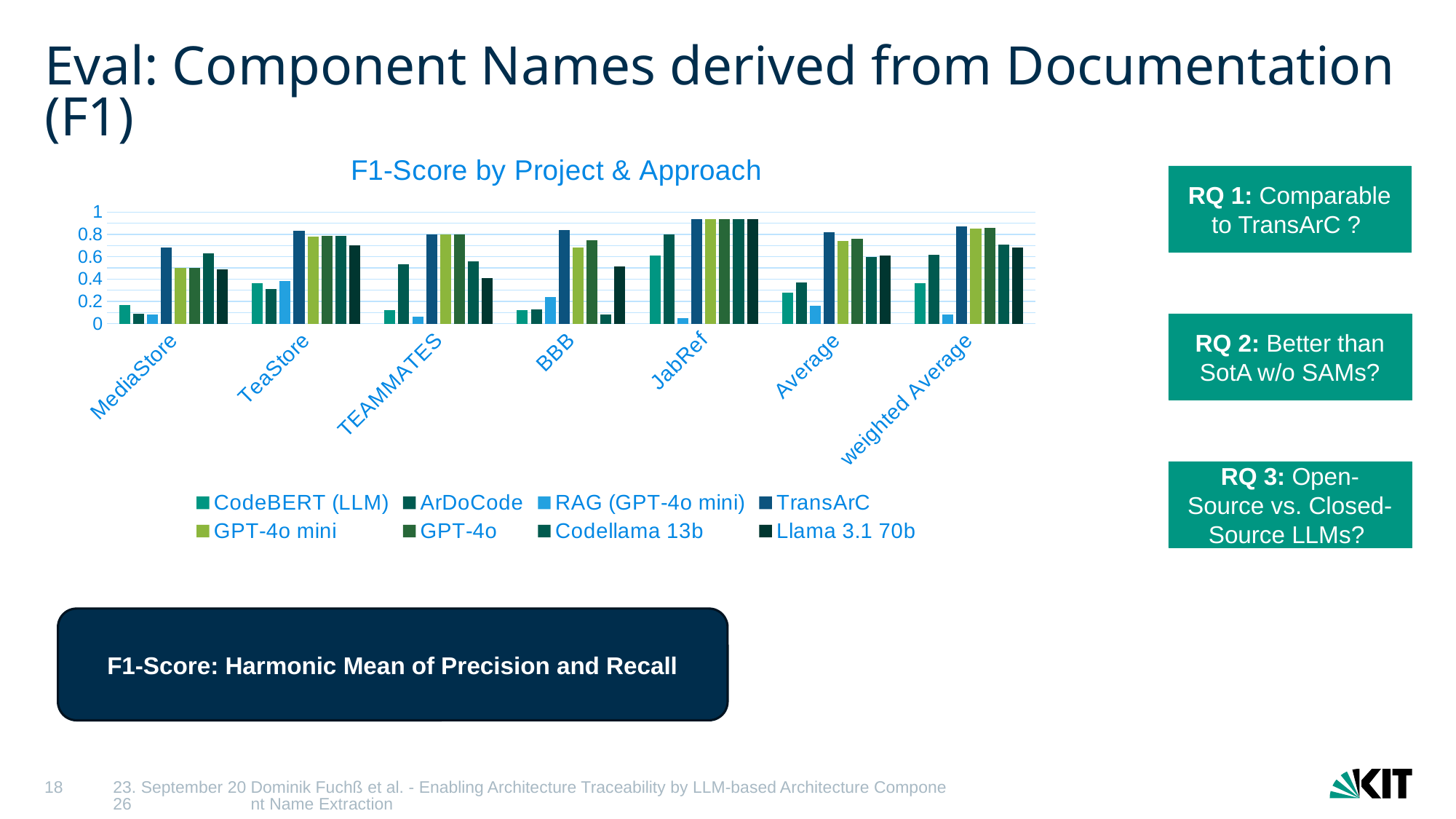
Is the value for RAG (GPT-4o mini) on JabRef greater or less than 0.2? less How many series does the chart's legend list? 8 How many project categories are shown along the x axis? 7 Is the value for Codellama 13b on MediaStore greater or less than 0.4? greater For which project is the TransArC bar highest? JabRef On MediaStore, which is larger: the TransArC value or the RAG (GPT-4o mini) value? TransArC What is the title of the chart? F1-Score by Project & Approach On BBB, which is larger: the RAG (GPT-4o mini) value or the ArDoCode value? RAG (GPT-4o mini) Is the value for GPT-4o mini on BBB greater or less than 0.6? greater What kind of chart is shown on the slide? bar chart